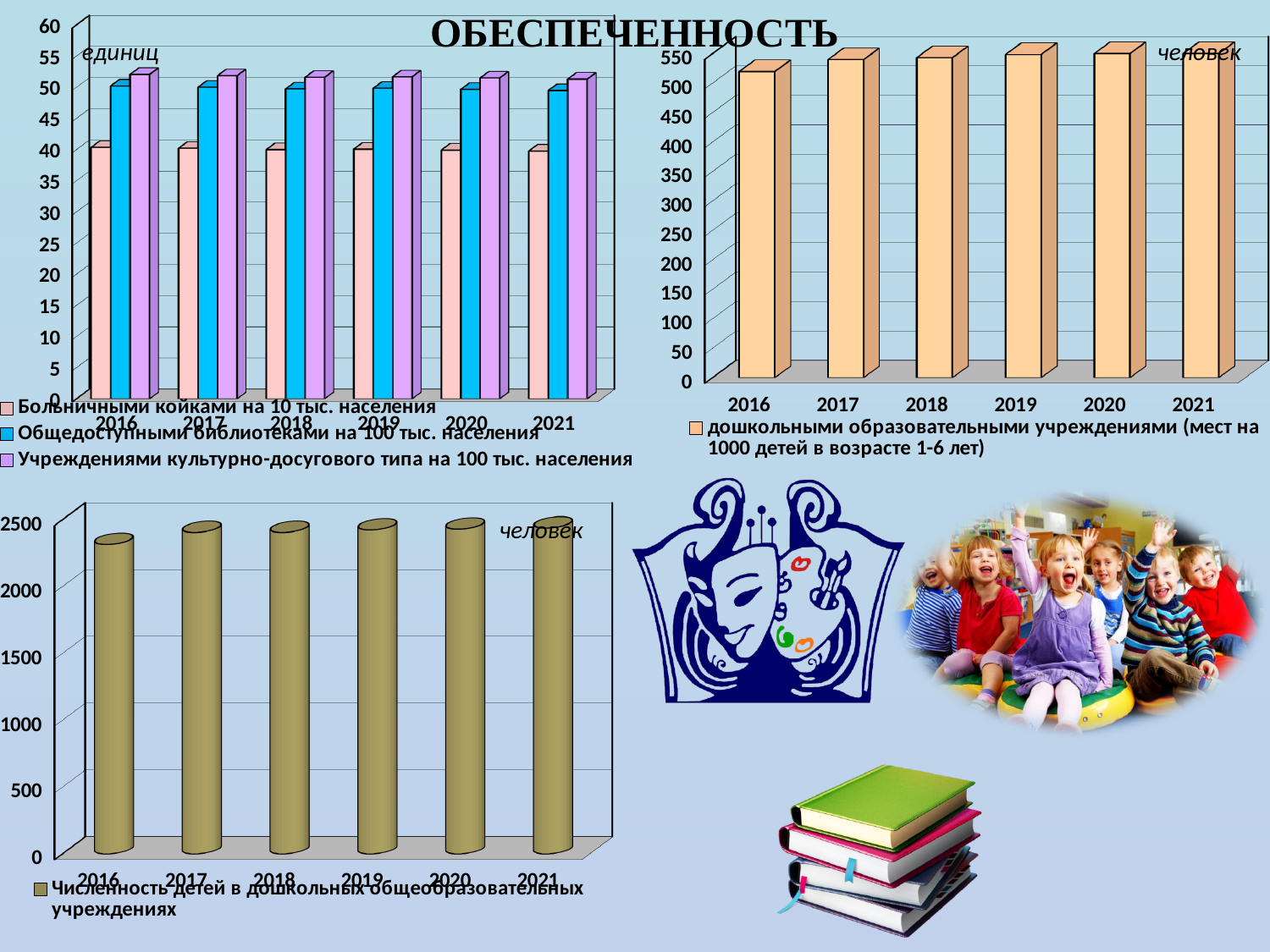
In the top-right chart, is the value for 2016 greater or less than 500? greater In the bottom-left chart, how many years are shown on the x axis? 6 In the top-left chart, is the value for 'Больничными койками на 10 тыс. населения' in 2016 greater or less than 45? less In the top-right chart, do the values rise or fall from 2016 to 2021? rise In the top-left chart, how many series does the legend list? 3 In the top-left chart, which is larger in 2021: 'Учреждениями культурно-досугового типа на 100 тыс. населения' or 'Больничными койками на 10 тыс. населения'? Учреждениями культурно-досугового типа на 100 тыс. населения In the bottom-left chart, is the value for 2018 greater or less than 2000? greater What kind of chart is the top-left chart? bar chart In the top-left chart, how many years are shown on the x axis? 6 What unit label is shown in the top-right chart? человек In the top-right chart, how many series does the legend list? 1